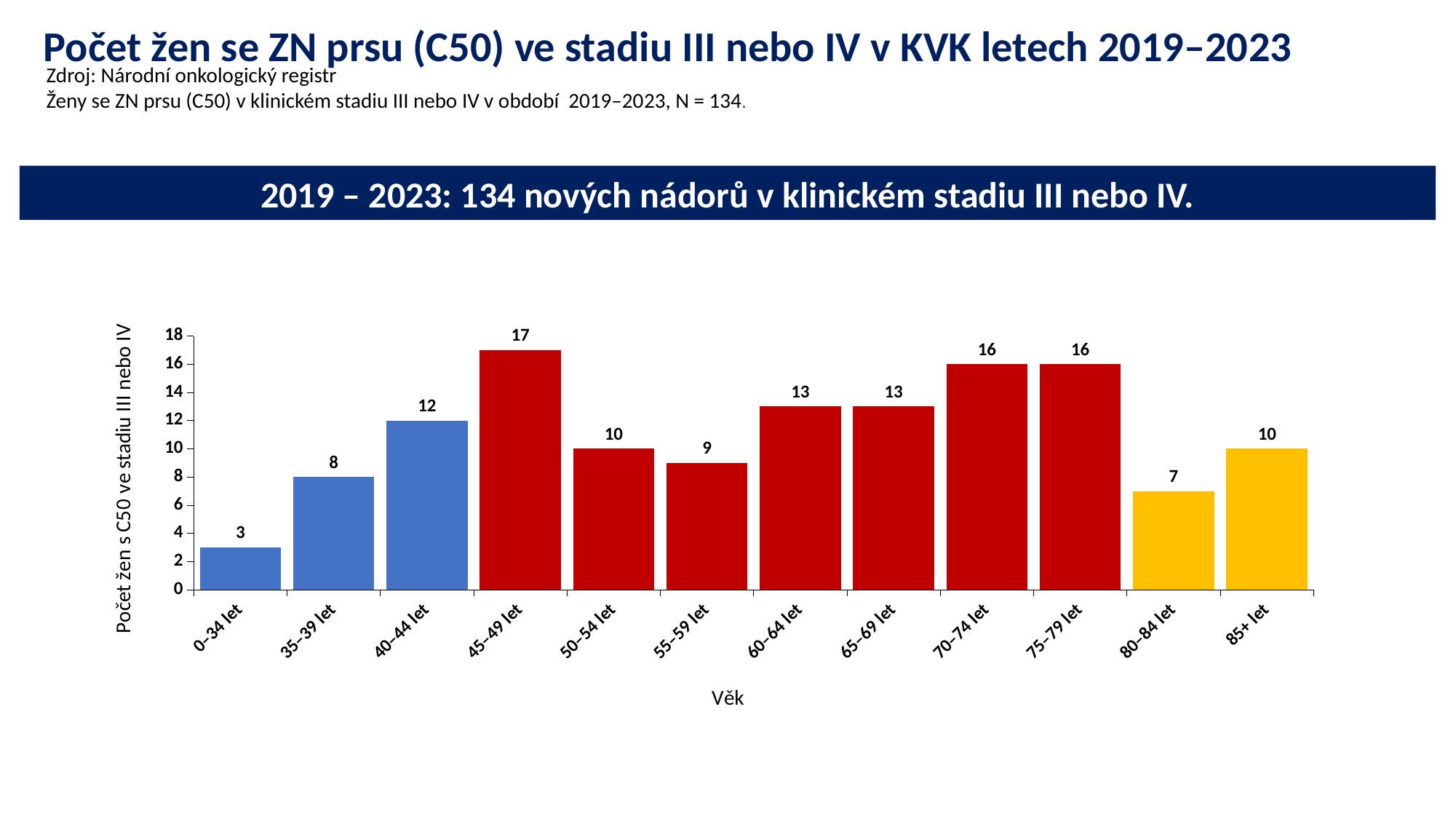
What is the label of the x axis? Věk What is the value for the 0–34 let age group? 3 How many age groups are shown on the x axis? 12 What is the value for the 80–84 let age group? 7 What is the difference between the values for 45–49 let and 55–59 let? 8 What is the value for the 45–49 let age group? 17 Do the values rise or fall from 0–34 let to 45–49 let? rise What kind of chart is shown on the slide? bar chart Which age group has the highest value? 45–49 let Which is larger, the value for 40–44 let or the value for 60–64 let? 60–64 let Which age group has the lowest value? 0–34 let Is the value for 70–74 let greater or less than 10? greater